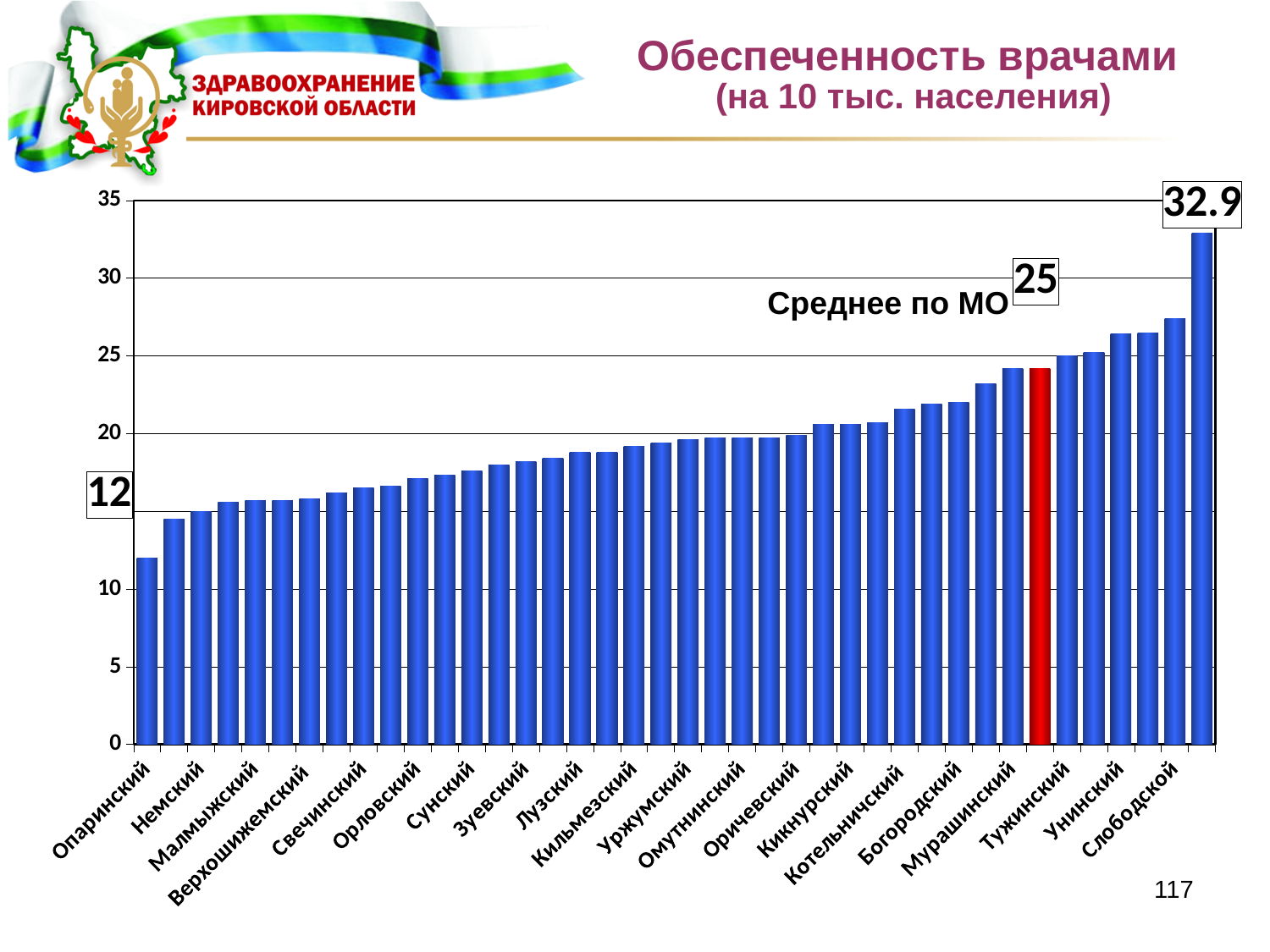
What is the value for Опаринский? 12 What colour is the highlighted bar that differs from the others? red Is the value for Унинский greater or less than 20? greater Which category has the lowest value? Опаринский Which is larger, the value for Немский or the value for Унинский? Унинский Is the value for Немский greater or less than 20? less What value is shown for Среднее по МО? 25 Do the values rise or fall from left to right along the x axis? rise What kind of chart is shown on the slide? bar chart